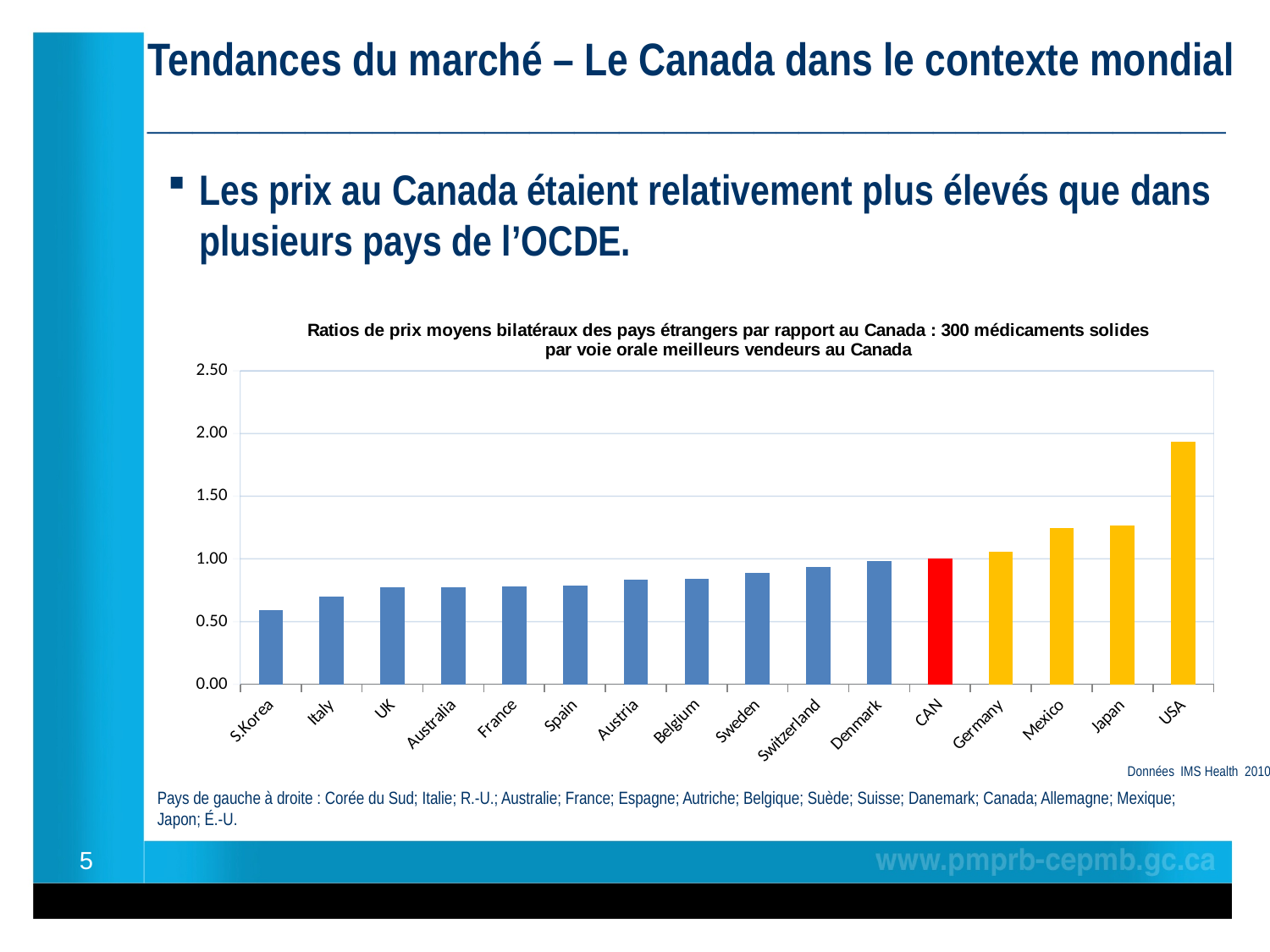
What kind of chart is shown on the slide? bar chart Is the value for S.Korea greater or less than 1.00? less Is the value for Italy greater or less than 0.50? greater What is the value for CAN on the chart? 1.00 How many countries are plotted on the chart? 16 Is the value for USA greater or less than 1.50? greater Which country has the lowest price ratio on the chart? S.Korea Which has a larger value, USA or Japan? USA What colour is the bar for CAN? red Which country has the highest price ratio on the chart? USA Do the values generally rise or fall from left to right along the x axis? rise